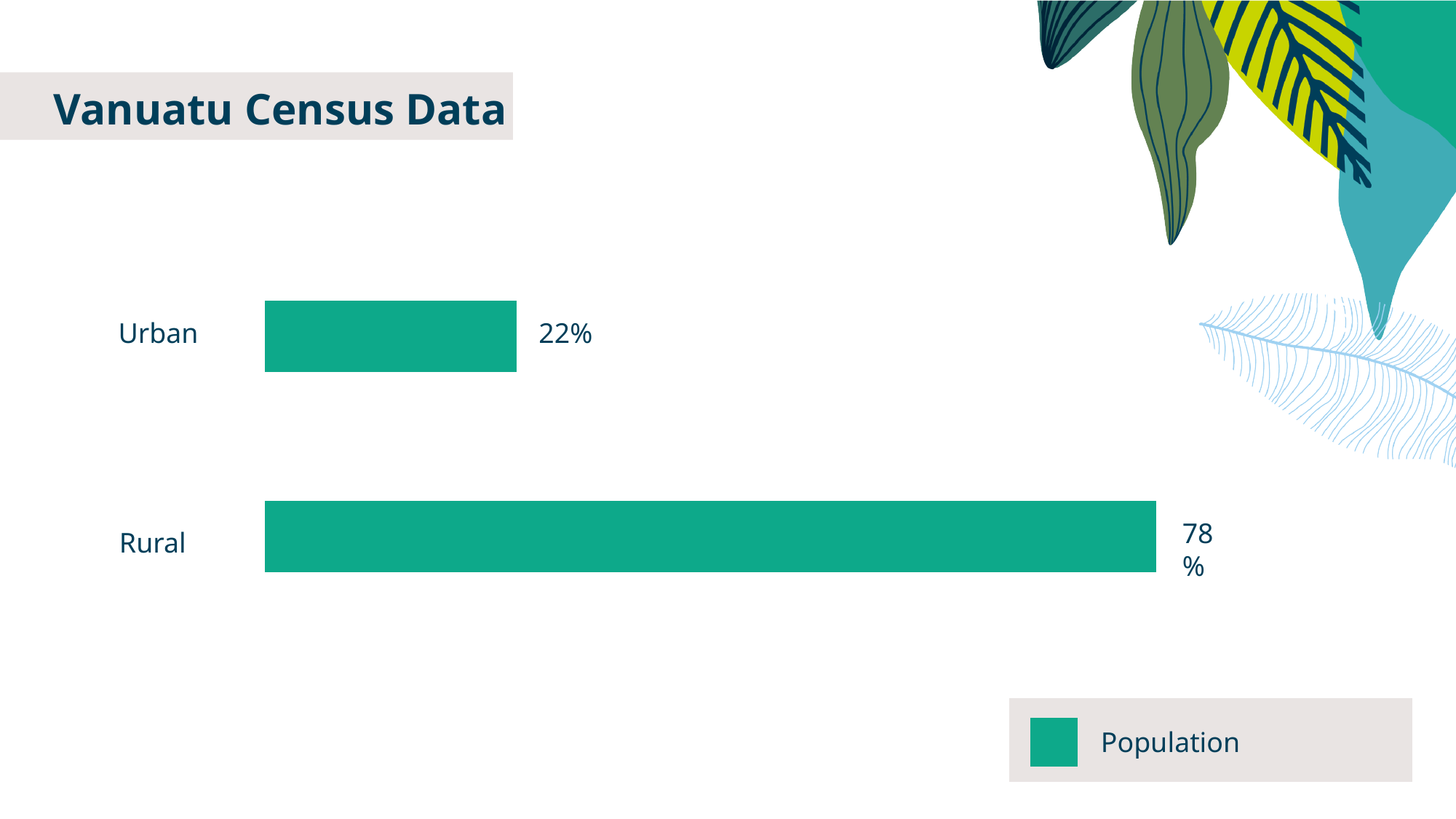
What is the Population value for Urban? 22% Which category has the lowest Population value? Urban Which is larger, the Population value for Urban or for Rural? Rural Which category has the highest Population value? Rural What is the difference between the Rural and Urban Population values? 56% What is the total of the Urban and Rural Population values? 100% What is the Population value for Rural? 78% What series name is shown in the legend? Population How many series does the legend list? 1 What kind of chart is shown on the slide? Bar chart What is the title of the chart? Vanuatu Census Data How many categories are shown in the chart? 2